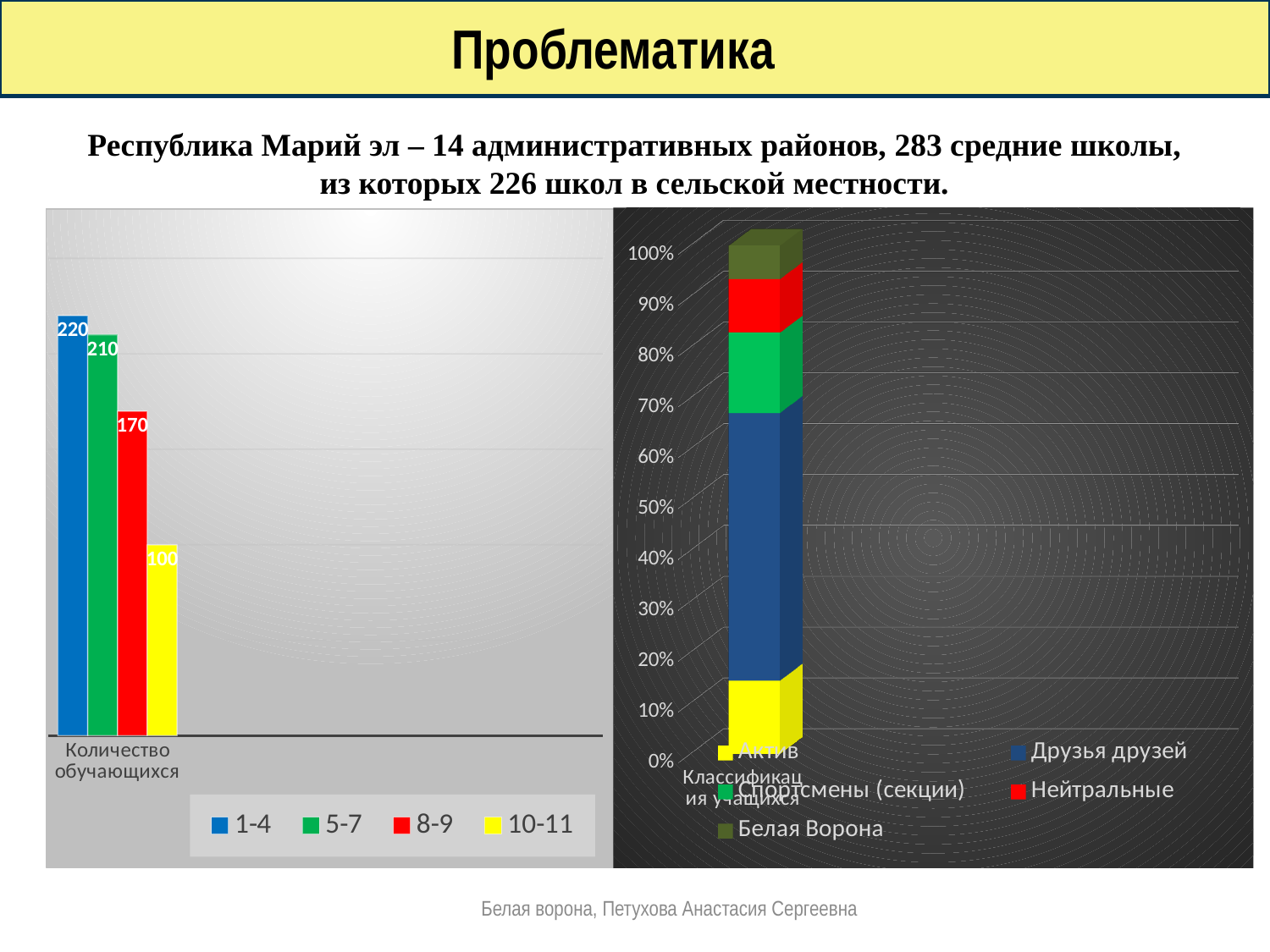
On the right chart, is the share for Белая Ворона greater or less than 10%? less On the left chart, what is the value for the 1-4 series? 220 On the left chart, what is the value for the 8-9 series? 170 On the left chart, what is the value for the 10-11 series? 100 On the left chart, what is the difference between the 1-4 and 10-11 values? 120 What kind of chart is the chart on the right side of the slide? Stacked bar chart On the left chart, which series has the lowest value? 10-11 How many series does the legend of the right chart list? 5 On the left chart, which series has the highest value? 1-4 How many series does the legend of the left chart list? 4 On the left chart, which is larger: the value for 5-7 or the value for 8-9? 5-7